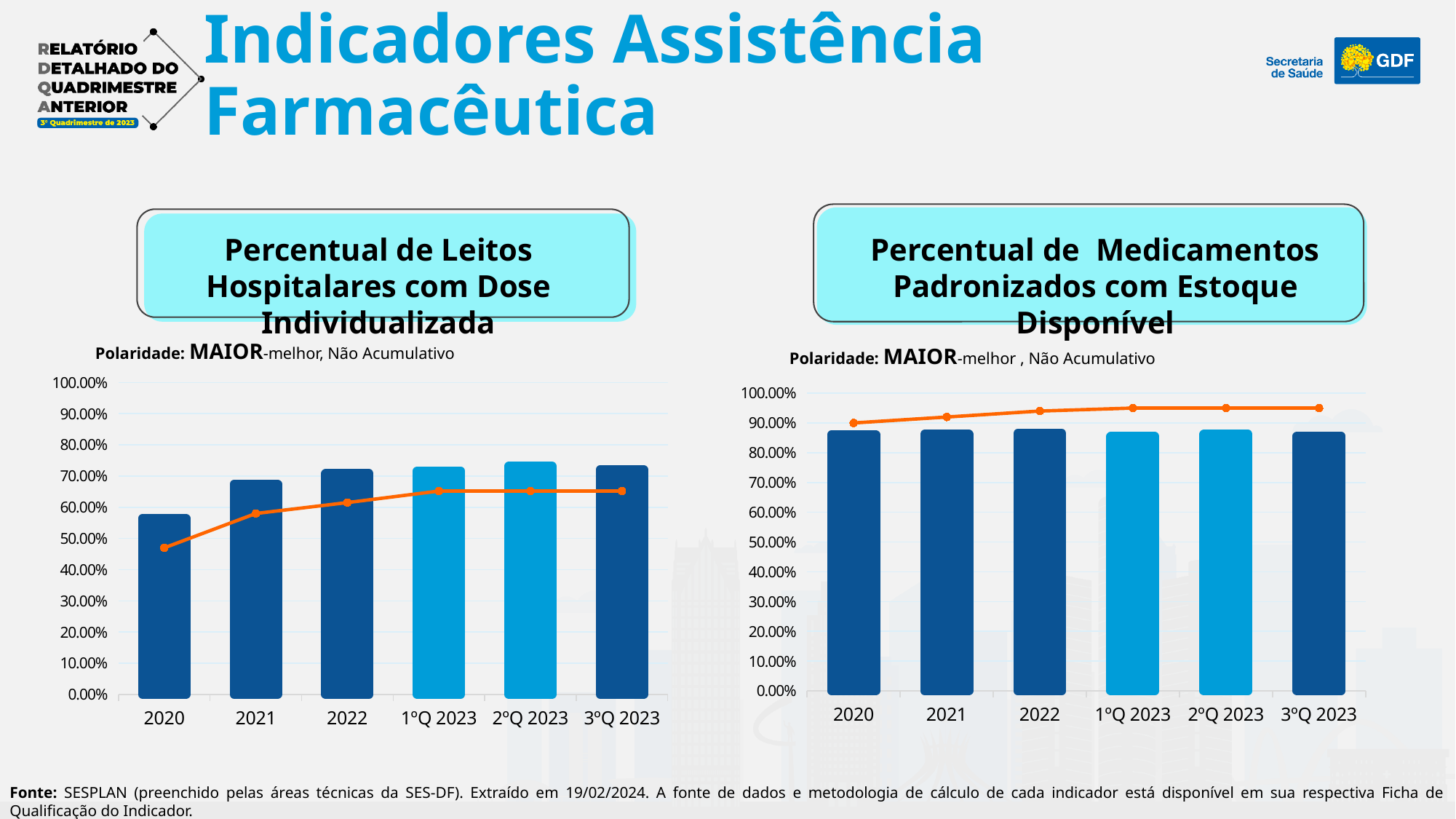
In the chart 'Percentual de Leitos Hospitalares com Dose Individualizada', which category has the lowest bar? 2020 In the chart 'Percentual de Medicamentos Padronizados com Estoque Disponível', what is the highest value shown on the y axis? 100.00% In the chart 'Percentual de Medicamentos Padronizados com Estoque Disponível', is the bar for 2020 greater or less than 80.00%? greater In the chart 'Percentual de Leitos Hospitalares com Dose Individualizada', does the orange line rise or fall from 2020 to 2022? rise In the chart 'Percentual de Leitos Hospitalares com Dose Individualizada', is the line point for 2020 greater or less than 50.00%? less In the chart 'Percentual de Medicamentos Padronizados com Estoque Disponível', is the line point for 3ºQ 2023 greater or less than 90.00%? greater In the chart 'Percentual de Medicamentos Padronizados com Estoque Disponível', how many bars are there? 6 In the chart 'Percentual de Leitos Hospitalares com Dose Individualizada', what kind of chart is shown? Bar chart with a line In the chart 'Percentual de Leitos Hospitalares com Dose Individualizada', which bar is taller, 2020 or 2021? 2021 In the chart 'Percentual de Leitos Hospitalares com Dose Individualizada', how many categories are on the x axis? 6